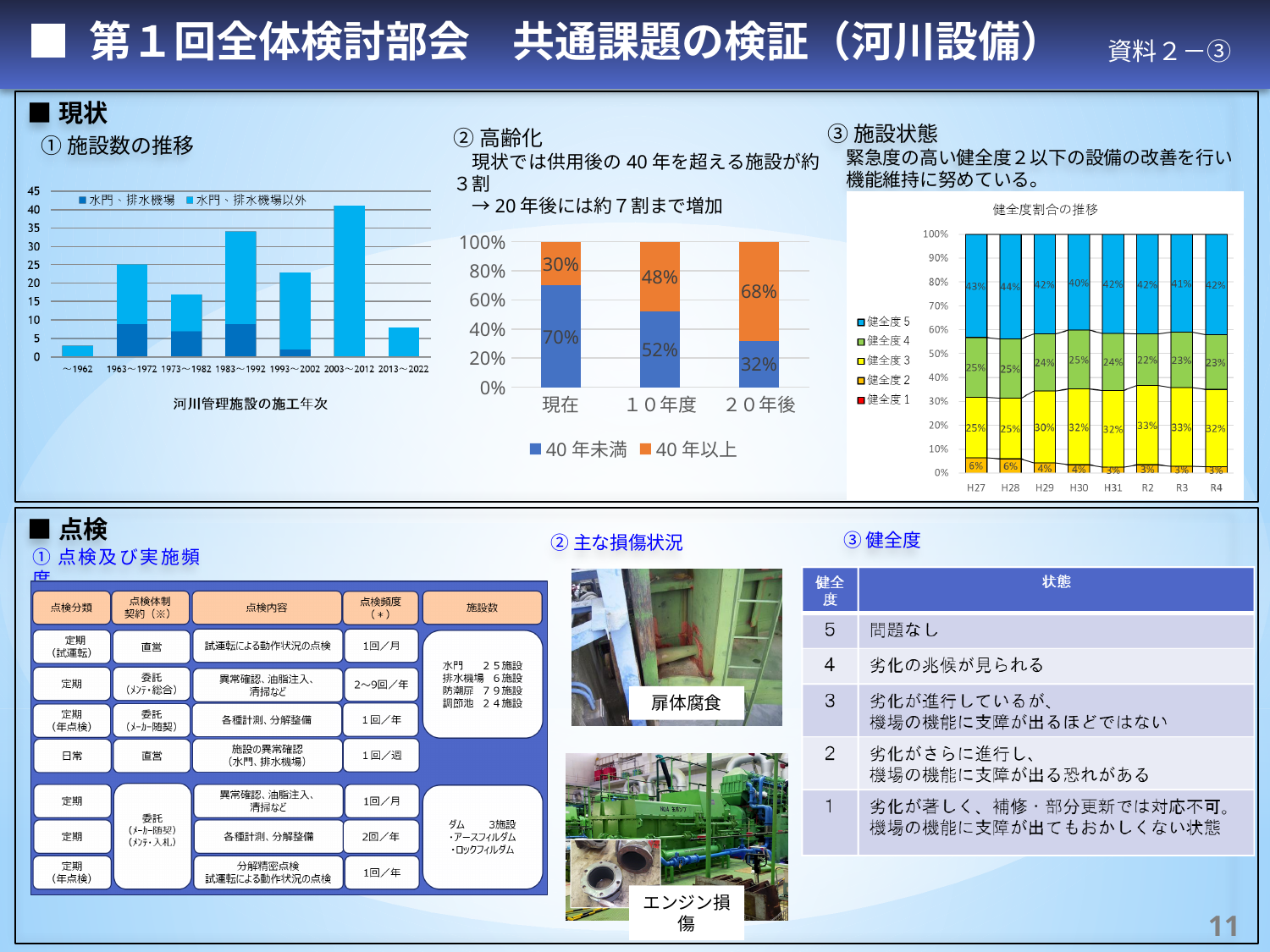
In the 高齢化 chart (現在 / １０年度 / ２０年後), what is the value of 40年以上 for 現在? 30% In the chart titled 健全度割合の推移, what is the value of 健全度2 for R4? 3% In the chart titled 施設数の推移, how many series does the legend list? 2 In the chart titled 施設数の推移, is the total value for ～1962 greater or less than 5? less In the chart titled 施設数の推移, which construction period has the highest total number of facilities? 2003～2012 In the chart titled 施設数の推移 (河川管理施設の施工年次), how many construction-period categories are shown on the x axis? 7 In the chart titled 施設数の推移, is the total value for 1983～1992 greater or less than 30? greater In the 高齢化 chart, what is the difference between the 40年以上 value for ２０年後 and for 現在? 38 percentage points In the chart titled 健全度割合の推移, what is the value of 健全度5 for H27? 43% In the 高齢化 chart, what is the value of 40年未満 for １０年度? 52% In the chart titled 健全度割合の推移, how many series does the legend list? 5 In the 高齢化 chart, does the share of 40年以上 rise or fall from 現在 to ２０年後? rise